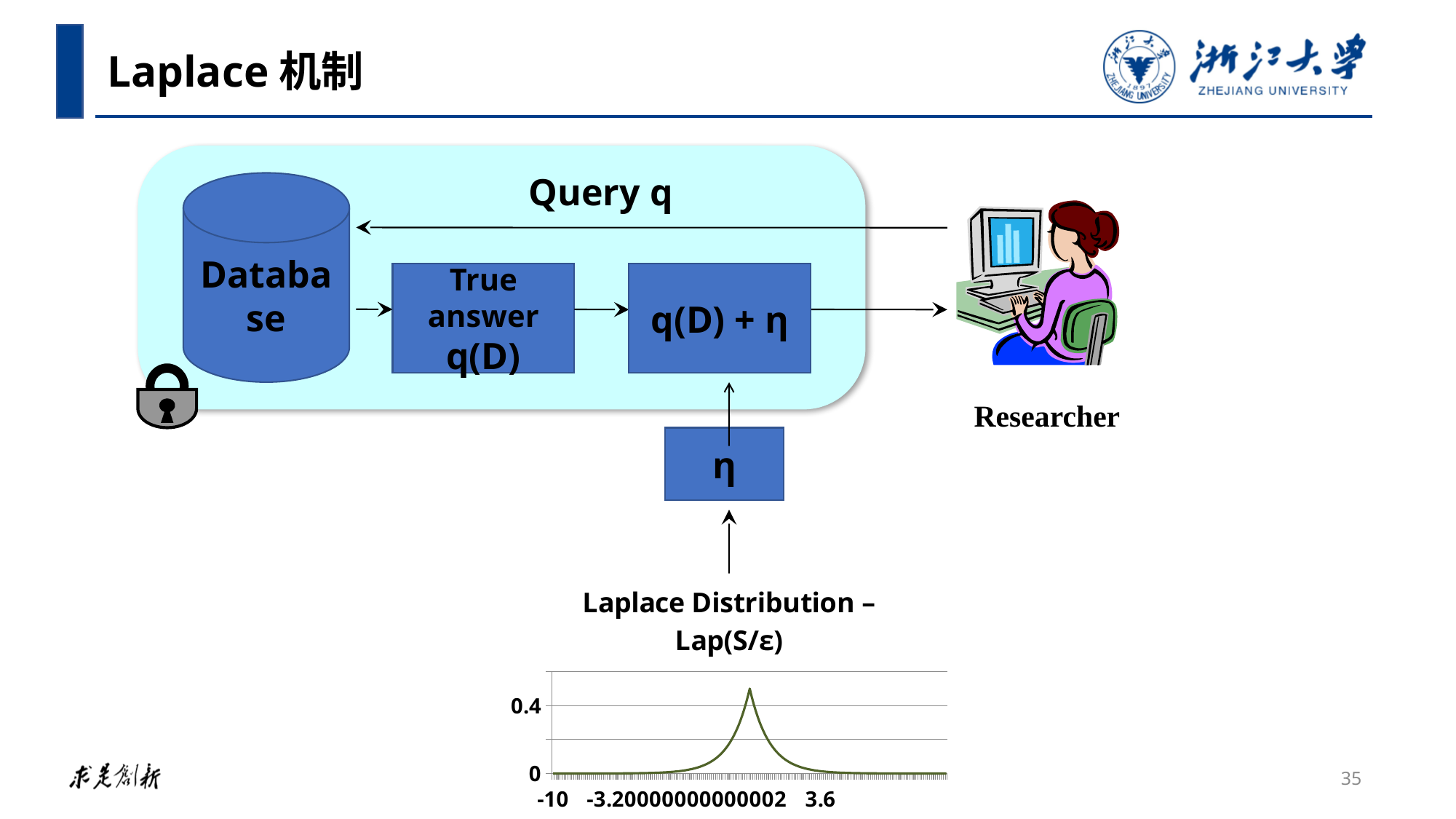
In the Laplace Distribution chart, is the value of the curve at x = -10 greater or less than 0.4? less In the Laplace Distribution chart, does the curve rise or fall as x moves from the peak toward the right end of the axis? fall In the Laplace Distribution chart, is the value of the curve at x = 3.6 greater or less than 0.4? less How many lines (series) are plotted in the Laplace Distribution chart? 1 In the Laplace Distribution chart, is the peak value of the curve greater or less than 0.4? greater What is the leftmost x-axis tick label on the Laplace Distribution chart? -10 What is the highest y-axis tick label shown on the Laplace Distribution chart? 0.4 In the Laplace Distribution chart, does the curve rise or fall as x moves from -10 toward the centre of the axis? rise What kind of chart is shown at the bottom of the slide? line chart What is the title of the chart at the bottom of the slide? Laplace Distribution – Lap(S/ε)